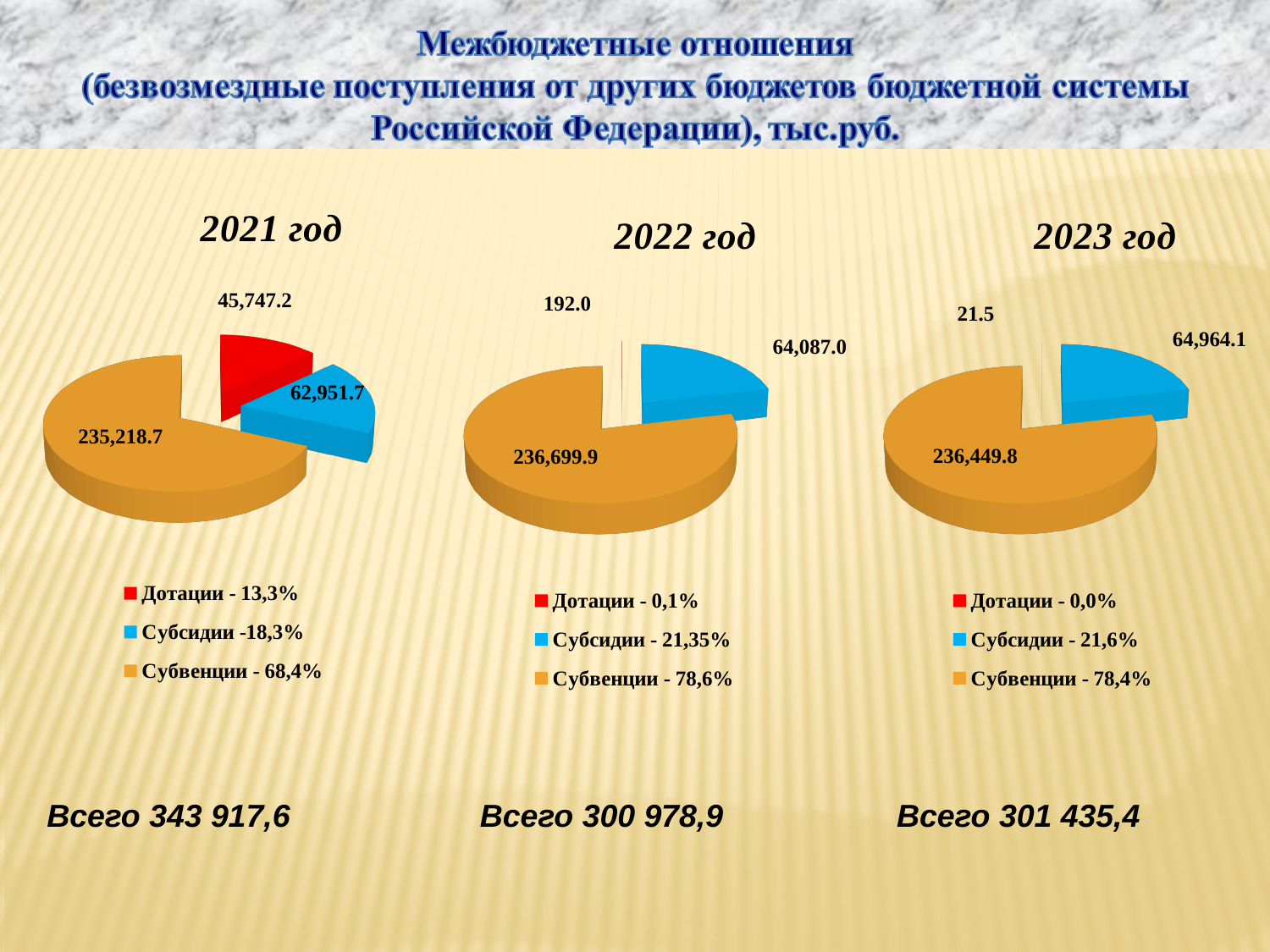
In the 2023 год chart, which category has the largest slice? Субвенции In the 2021 год chart, what is the value for Субвенции? 235,218.7 What type of chart is used for the 2022 год data? Pie chart In the 2023 год chart, what share of the pie does Субсидии take according to the legend? 21,6% In the 2023 год chart, what is the value for Дотации? 21.5 In the 2021 год chart, what share of the pie does Субвенции take according to the legend? 68,4% In the 2021 год chart, which is larger: Субсидии or Дотации? Субсидии What total (Всего) is shown under the 2023 год chart? 301 435,4 In the 2022 год chart, what is the value for Субсидии? 64,087.0 In the 2022 год chart, which category has the smallest slice? Дотации In the 2021 год chart, what is the value for Дотации? 45,747.2 How many categories does the legend of the 2022 год chart list? 3